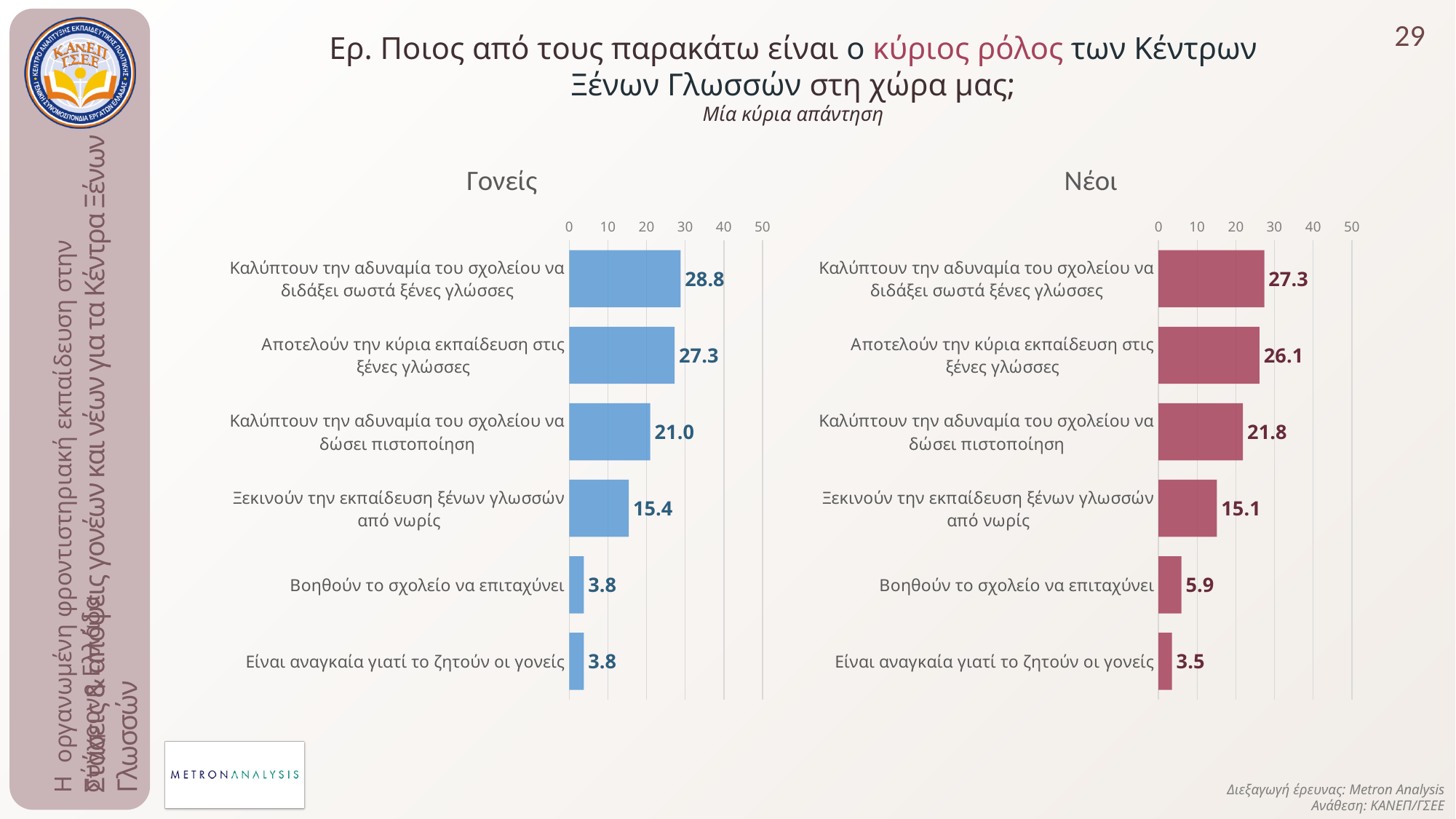
Which is larger: the value for 'Ξεκινούν την εκπαίδευση ξένων γλωσσών από νωρίς' in the 'Γονείς' chart or in the 'Νέοι' chart? Γονείς What kind of chart is the 'Νέοι' chart? bar chart In the 'Γονείς' chart, what is the value for 'Καλύπτουν την αδυναμία του σχολείου να διδάξει σωστά ξένες γλώσσες'? 28.8 In the 'Νέοι' chart, is the value for 'Καλύπτουν την αδυναμία του σχολείου να δώσει πιστοποίηση' greater or less than 20? greater In the 'Νέοι' chart, what is the difference between 'Καλύπτουν την αδυναμία του σχολείου να διδάξει σωστά ξένες γλώσσες' and 'Αποτελούν την κύρια εκπαίδευση στις ξένες γλώσσες'? 1.2 In the 'Γονείς' chart, what is the value for 'Είναι αναγκαία γιατί το ζητούν οι γονείς'? 3.8 What colour are the bars in the 'Γονείς' chart? blue How many categories are shown in the 'Γονείς' chart? 6 In the 'Νέοι' chart, what is the value for 'Βοηθούν το σχολείο να επιταχύνει'? 5.9 In the 'Νέοι' chart, which category has the highest value? Καλύπτουν την αδυναμία του σχολείου να διδάξει σωστά ξένες γλώσσες In the 'Νέοι' chart, which category has the lowest value? Είναι αναγκαία γιατί το ζητούν οι γονείς In the 'Γονείς' chart, what is the difference between 'Αποτελούν την κύρια εκπαίδευση στις ξένες γλώσσες' and 'Καλύπτουν την αδυναμία του σχολείου να δώσει πιστοποίηση'? 6.3